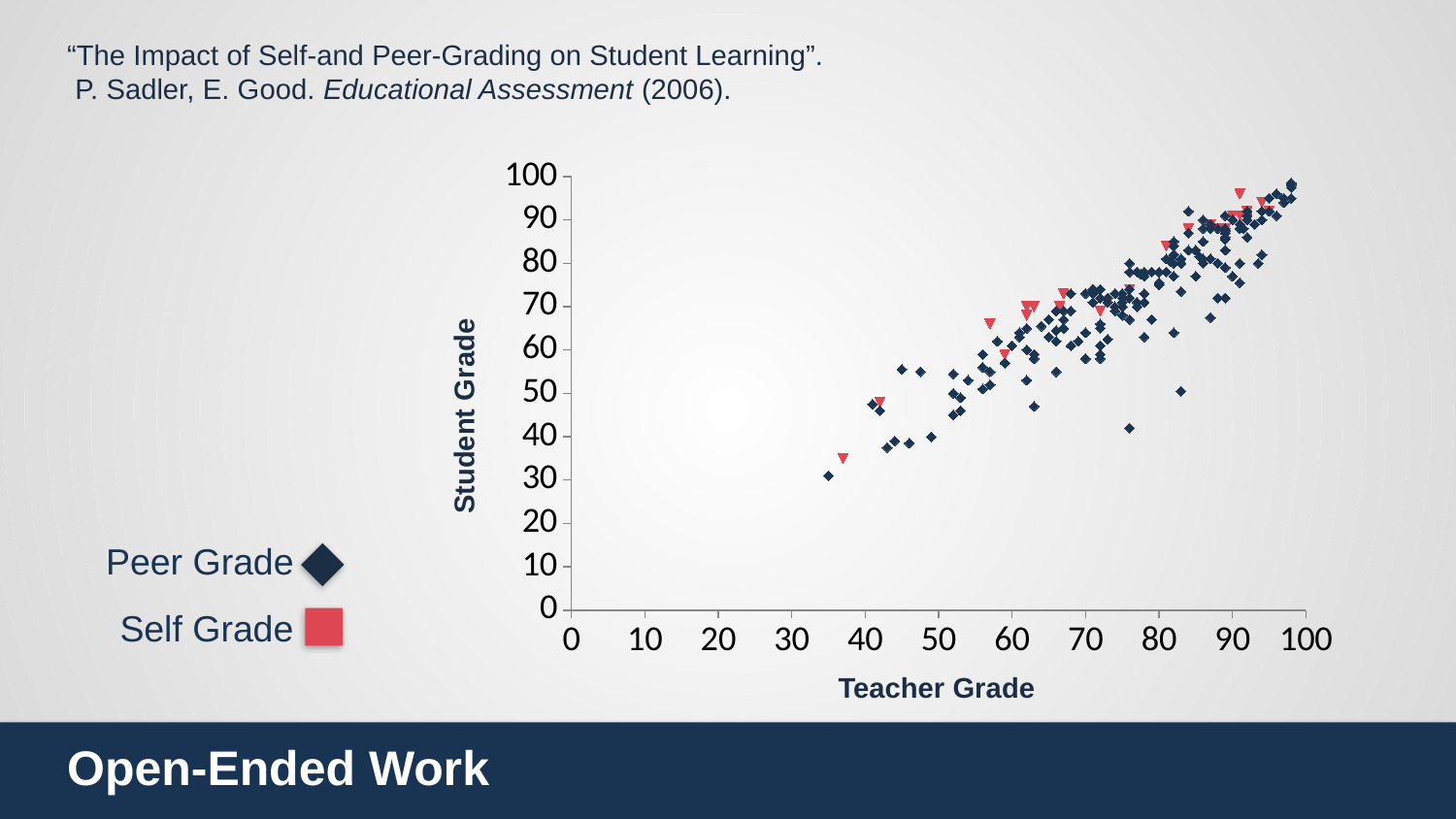
As Teacher Grade increases along the x axis, do Student Grade values generally rise or fall? rise How many series does the legend list? 2 Are there any plotted points with a Teacher Grade less than 30? no What is the label of the y axis? Student Grade What are the two series named in the legend? Peer Grade and Self Grade Which series is shown with red triangle markers? Self Grade Is the lowest plotted Student Grade value greater or less than 40? less What kind of chart is shown on the slide? scatter chart What is the label of the x axis? Teacher Grade What is the highest tick value shown on the y axis? 100 What is the highest tick value shown on the x axis? 100